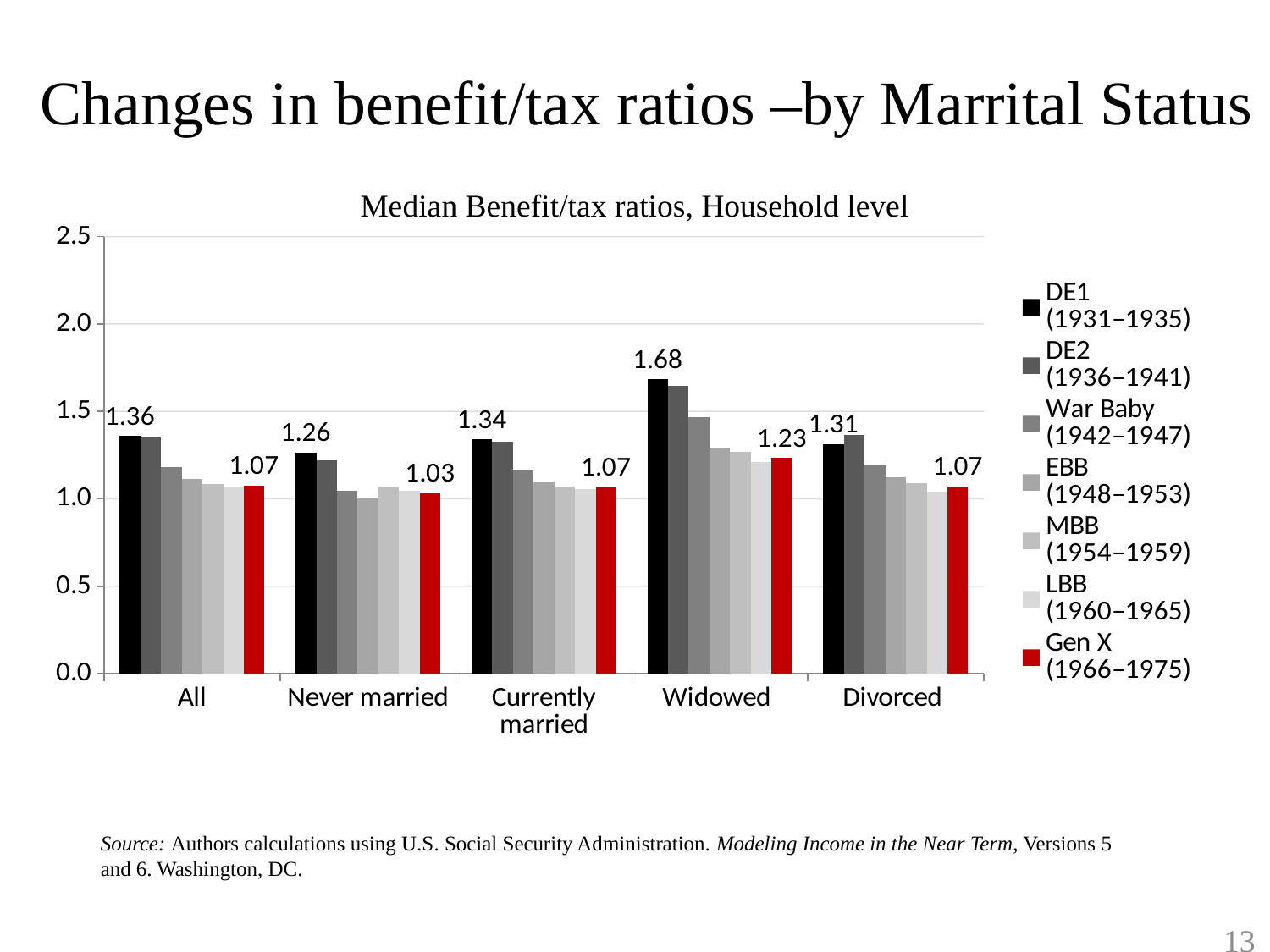
Which is larger: the DE1 (1931–1935) value for Never married or for Currently married? Currently married Which marital status category has the lowest Gen X (1966–1975) value? Never married Which marital status category has the highest DE1 (1931–1935) value? Widowed What is the difference between the DE1 (1931–1935) and Gen X (1966–1975) values in the Widowed category? 0.45 What kind of chart is shown on the slide? Bar chart What is the value for Gen X (1966–1975) in the Never married category? 1.03 What is the value for DE1 (1931–1935) in the All category? 1.36 What is the title of the chart? Median Benefit/tax ratios, Household level How many series does the legend list? 7 What is the value for DE1 (1931–1935) in the Widowed category? 1.68 Is the value for DE2 (1936–1941) in the Widowed category greater or less than 1.5? greater How many marital status categories are shown on the x axis? 5